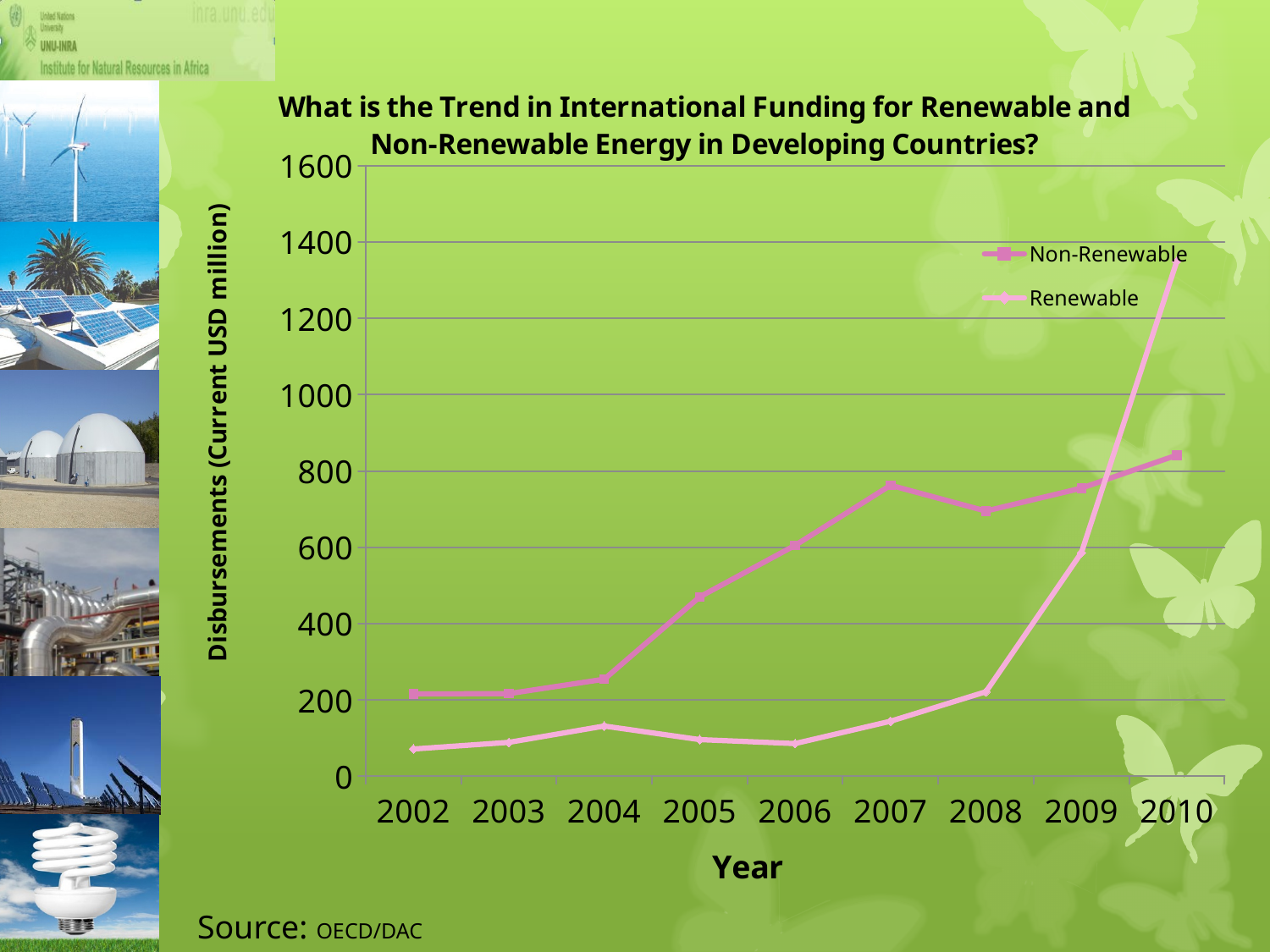
In 2008, which series has the larger value, Renewable or Non-Renewable? Non-Renewable Is the value for Non-Renewable in 2002 greater or less than 400? less What kind of chart is shown on the slide? Line chart Is the value for Non-Renewable in 2010 greater or less than 1000? less In which year is the Renewable series at its highest? 2010 In 2010, which series has the larger value, Renewable or Non-Renewable? Renewable Does the Renewable series rise or fall from 2008 to 2010? Rise What is the label on the y axis? Disbursements (Current USD million) How many years are shown on the x axis? 9 Is the value for Non-Renewable in 2006 greater or less than 400? greater How many series does the legend list? 2